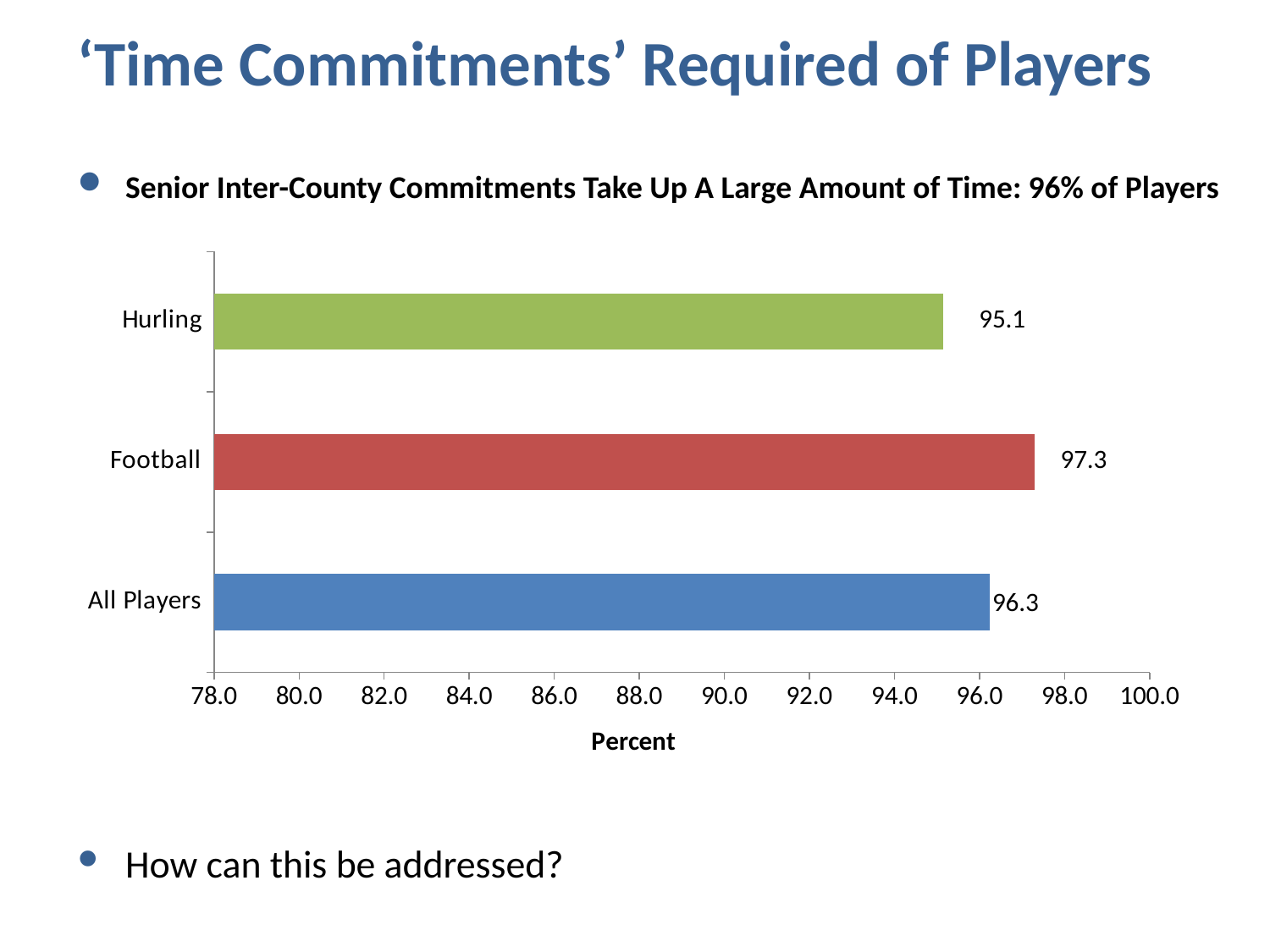
What is the value for All Players? 96.3 What is the value for Hurling? 95.1 Is the value for Hurling greater or less than 96.0? less What is the label of the horizontal axis? Percent How many categories are shown in the chart? 3 What kind of chart is shown on the slide? bar chart What is the difference between the values for All Players and Hurling? 1.2 Which category has the highest value? Football Which is larger, the value for Football or the value for All Players? Football What is the value for Football? 97.3 Which category has the lowest value? Hurling What is the difference between the values for Football and Hurling? 2.2